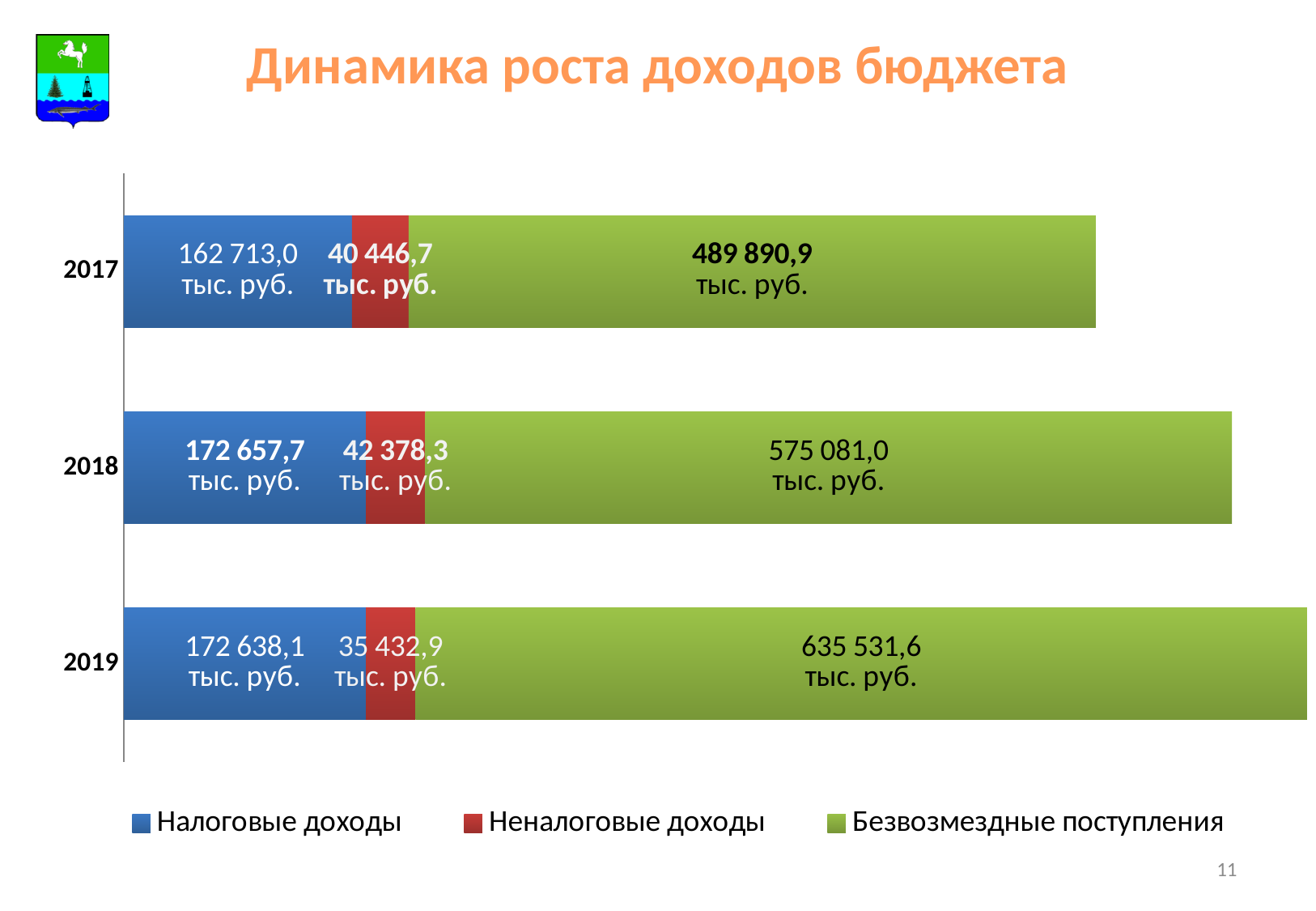
Does the total length of the stacked bars rise or fall from 2017 to 2019? Rise How many series does the legend list? 3 In which year is Безвозмездные поступления the highest? 2019 What is the difference between Безвозмездные поступления in 2019 and in 2018? 60 450,6 тыс. руб. Which series is shown in green in the legend? Безвозмездные поступления What is the total of the stacked bar for 2018? 790 117,0 тыс. руб. What type of chart is shown on the slide? Stacked bar chart What is the value of Налоговые доходы for 2017? 162 713,0 тыс. руб. What is the value of Неналоговые доходы for 2018? 42 378,3 тыс. руб. In which year is Неналоговые доходы the lowest? 2019 How many years (categories) are plotted on the chart? 3 What is the value of Безвозмездные поступления for 2019? 635 531,6 тыс. руб.